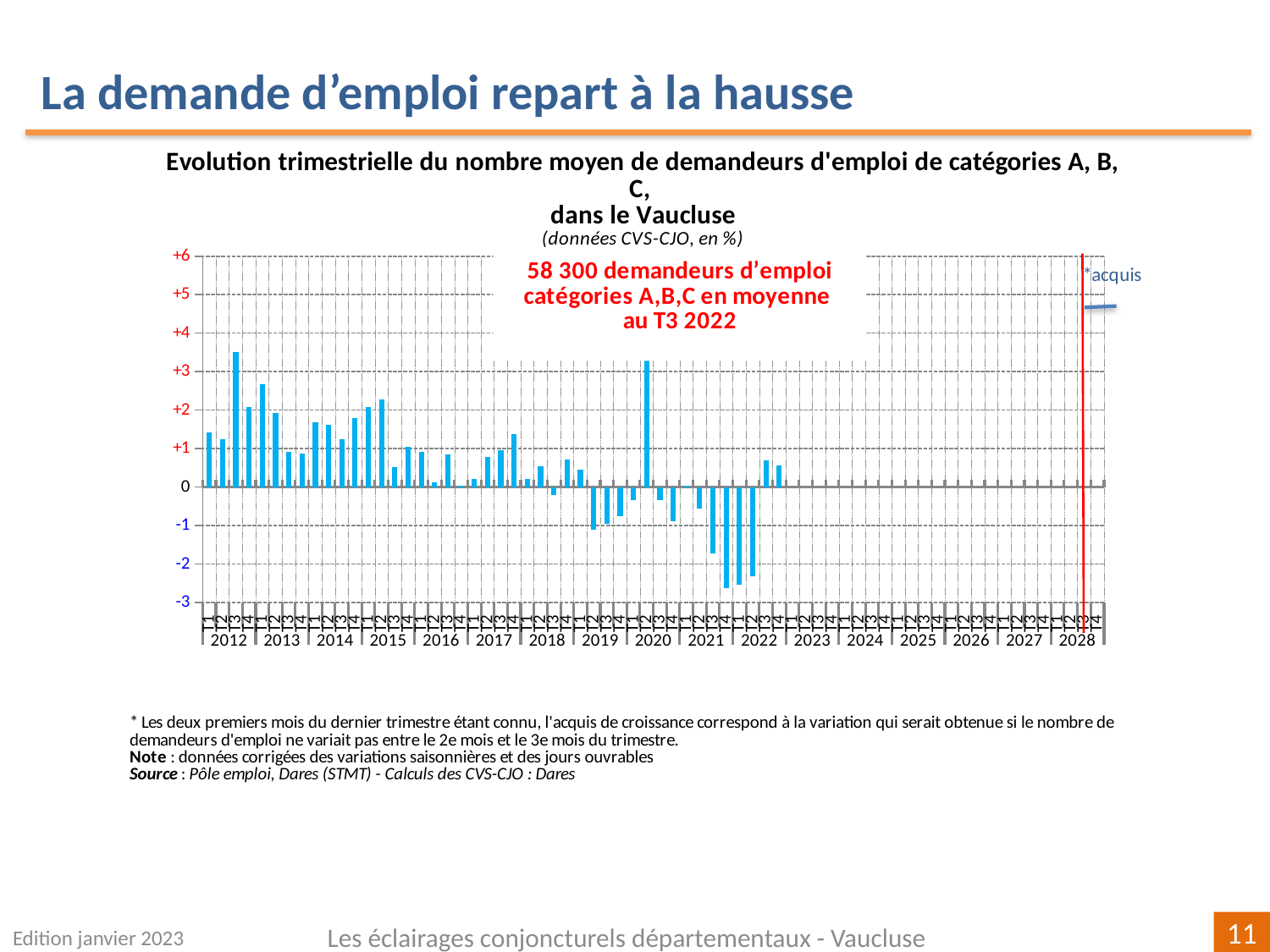
In what unit are the values of the chart expressed, according to the subtitle? en % Is the value for T4 2021 greater or less than -2? less According to the red annotation on the chart, how many job seekers in categories A, B, C were there on average in T3 2022? 58 300 Which is larger, the value for T3 2012 or the value for T2 2013? T3 2012 Which is larger, the value for T3 2021 or the value for T4 2021? T3 2021 What kind of chart is shown on the slide? Bar chart Is the value for T3 2022 greater or less than 0? greater Is the value for T3 2012 greater or less than +3? greater Do the values rise or fall from T4 2021 to T3 2022? rise